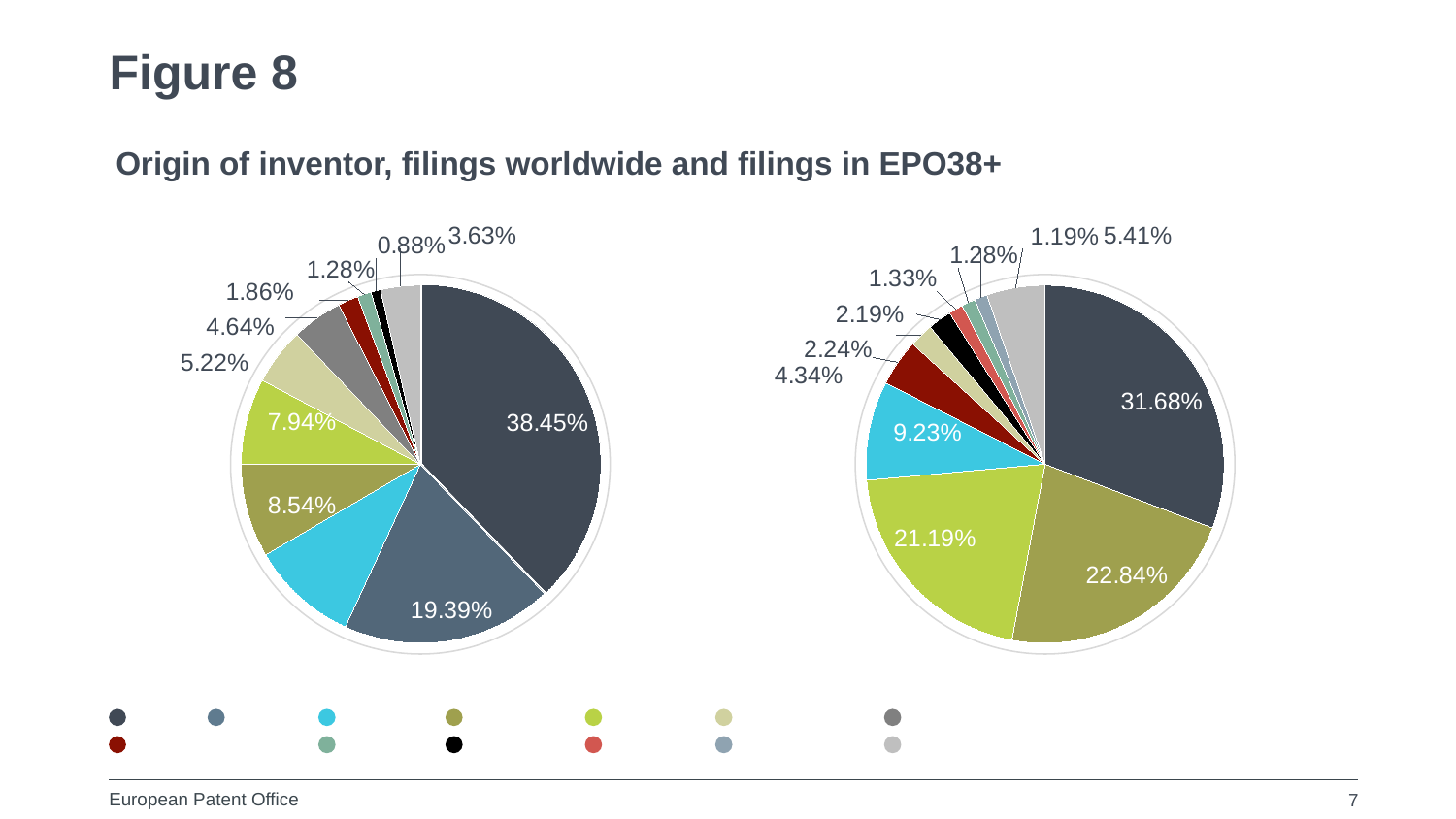
In the left pie chart, what is the smallest labelled value? 0.88% In the right pie chart, what is the difference between the 22.84% slice and the 21.19% slice? 1.65 percentage points What is the difference between the largest slice of the left pie chart (38.45%) and the largest slice of the right pie chart (31.68%)? 6.77 percentage points In the left pie chart, what is the value of the largest slice? 38.45% In the left pie chart, what is the value of the second-largest slice? 19.39% What kind of chart is used on this slide? Pie chart In the left pie chart, what is the difference between the two largest slices, 38.45% and 19.39%? 19.06 percentage points How many charts are shown on the slide? 2 Which chart has the larger largest slice, the left pie chart or the right pie chart? The left pie chart What is the subtitle describing the charts on the slide? Origin of inventor, filings worldwide and filings in EPO38+ In the right pie chart, what is the smallest labelled value? 1.19% In the right pie chart, what is the value of the largest slice? 31.68%